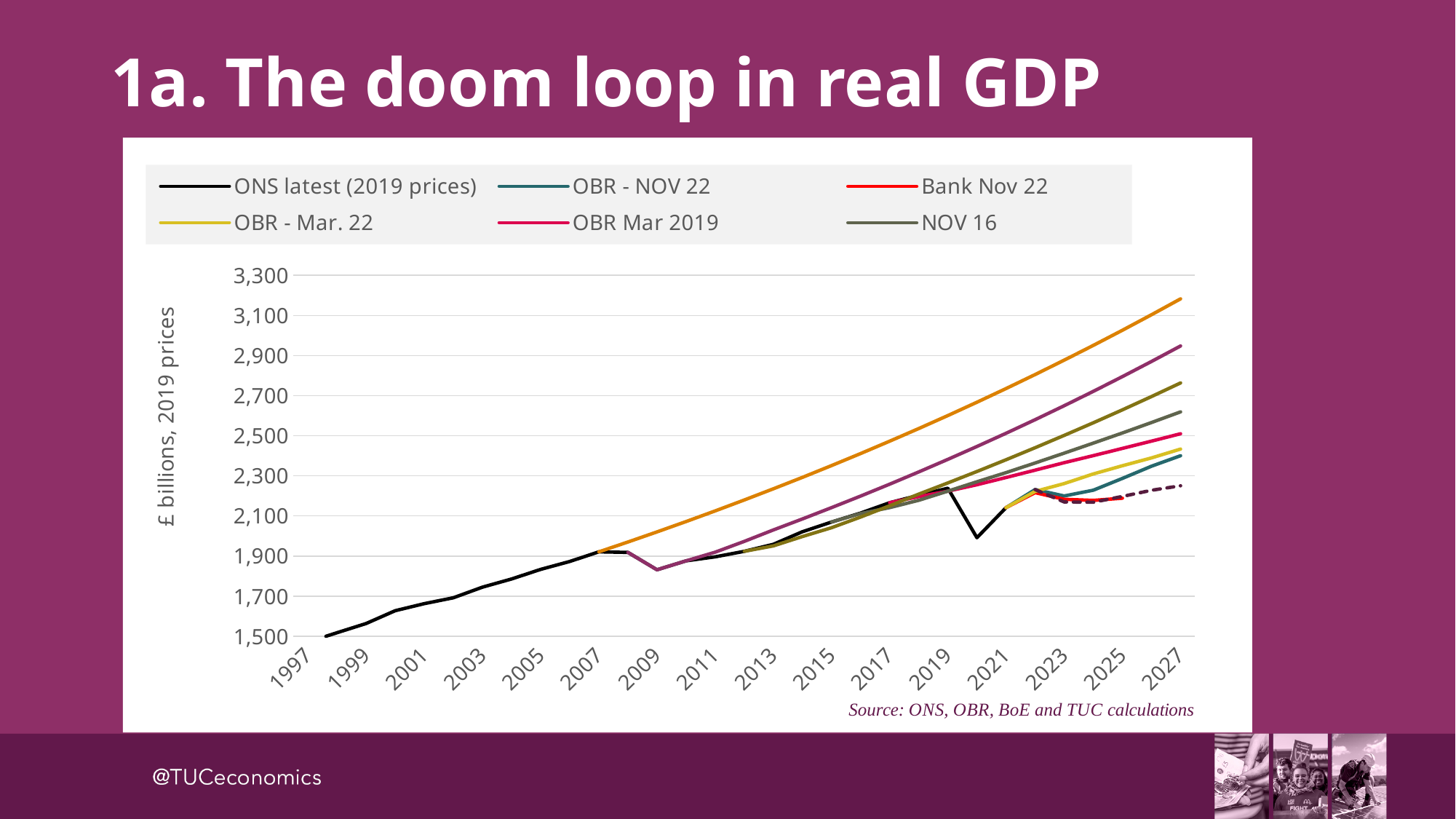
How many series does the legend list? 6 Does the ONS latest (2019 prices) series rise or fall between 1997 and 2007? rise Is the value of the OBR - NOV 22 series in 2027 greater or less than 2,300? greater How many year labels are shown on the x axis? 16 Is the value of the ONS latest (2019 prices) series in 2019 greater or less than 2,100? greater What is the label on the vertical axis? £ billions, 2019 prices What kind of chart is shown on the slide? line chart Is the value of the NOV 16 series in 2027 greater or less than 2,500? greater In 2027, which series is higher: NOV 16 or OBR - NOV 22? NOV 16 What is the title of the slide? 1a. The doom loop in real GDP